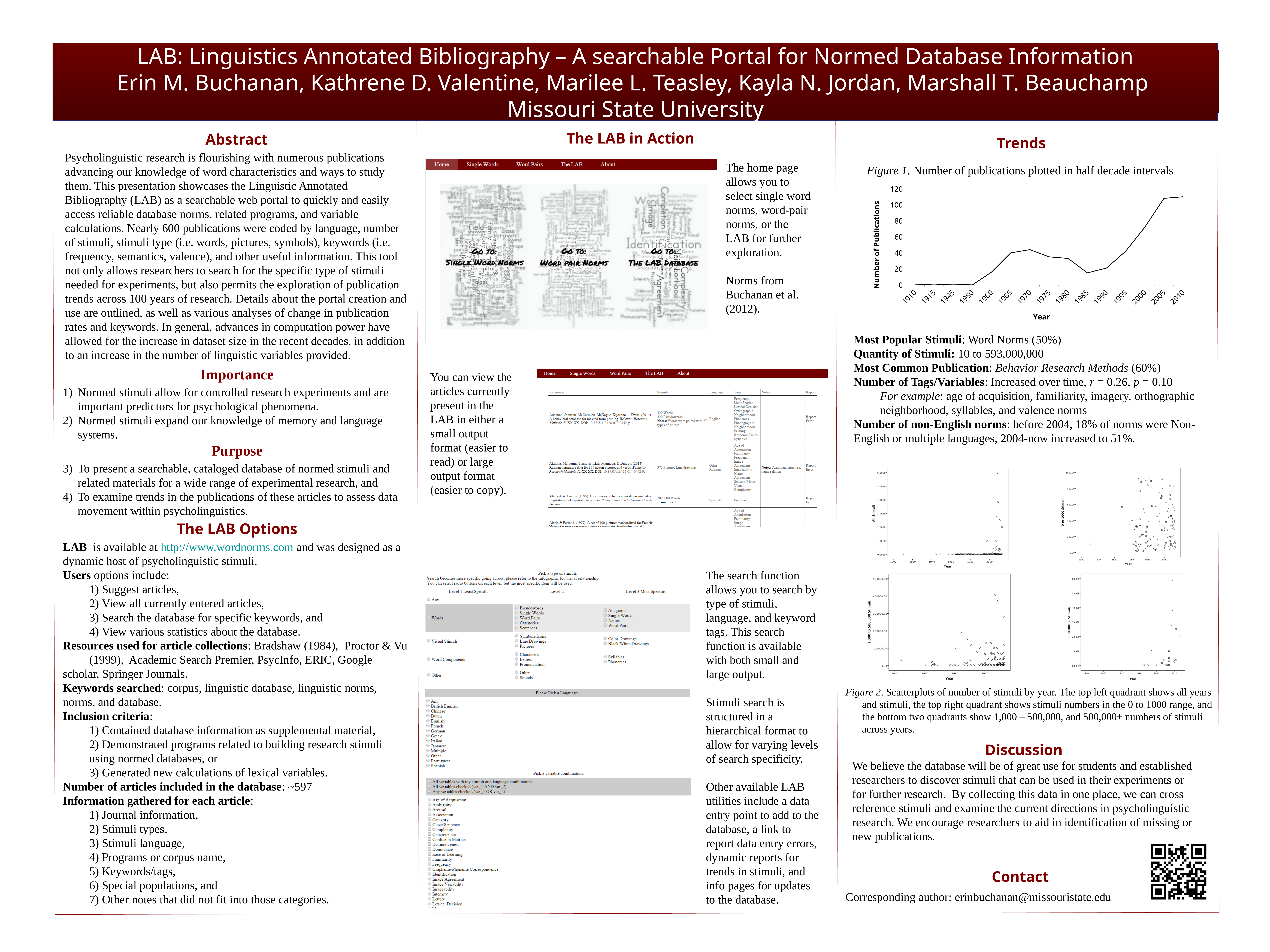
In Figure 1, is the number of publications for 1960 greater or less than 40? less In Figure 1, which year has more publications, 1970 or 1985? 1970 How many scatterplots are shown in Figure 2? 4 In Figure 1, is the number of publications for 1985 greater or less than 20? less In Figure 1, does the number of publications rise or fall between 1985 and 2005? rise In Figure 1, is the number of publications for 2000 greater or less than 60? greater What is the label on the y axis of Figure 1? Number of Publications What kind of chart is Figure 1 (Number of publications plotted in half decade intervals)? line chart In Figure 1, which year has more publications, 1990 or 2000? 2000 In Figure 1, how many year labels are shown along the x axis? 15